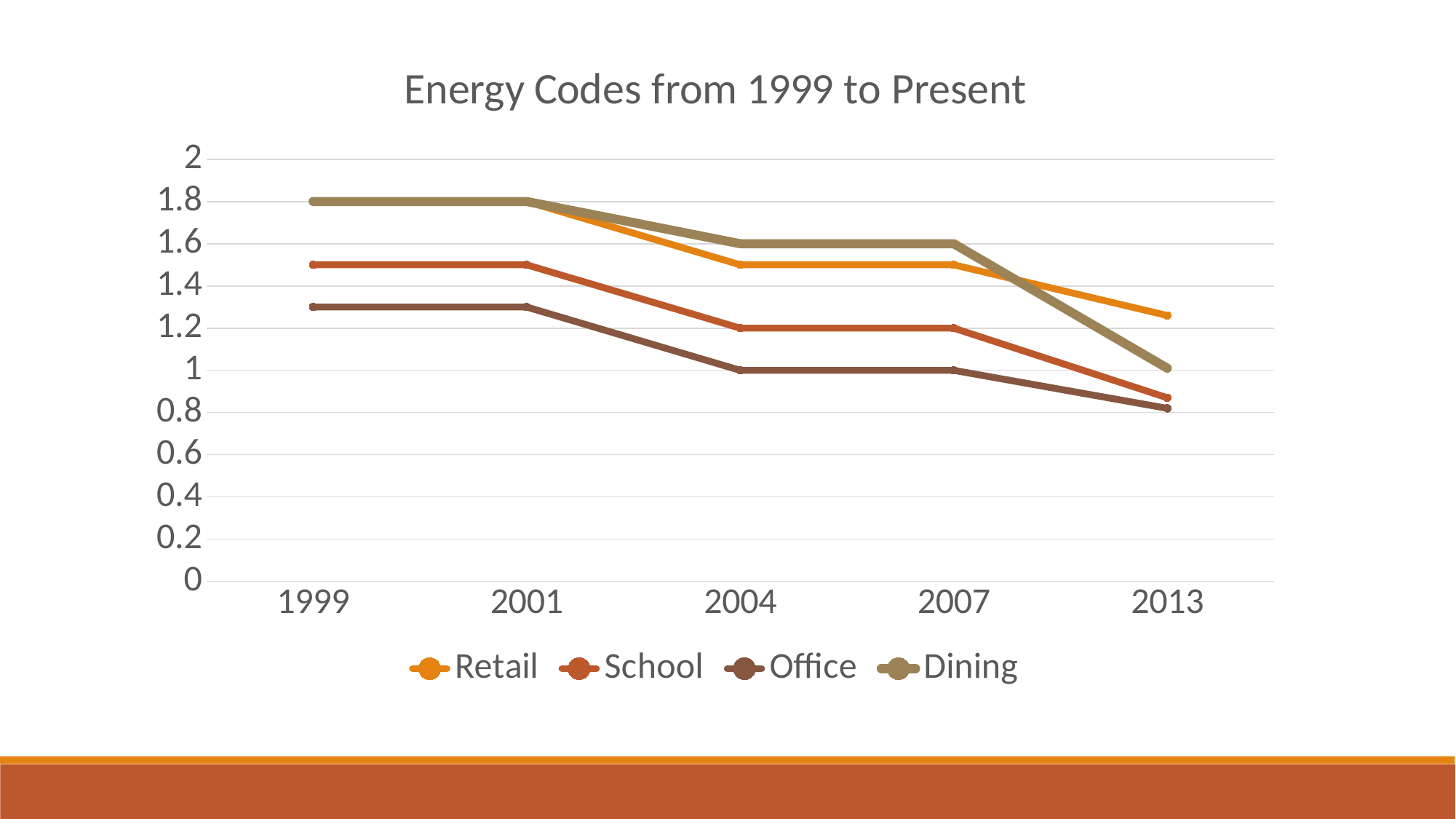
Does the Office series rise or fall from 1999 to 2013? fall What is the value for Office in 2004? 1 How many series does the legend list? 4 How many years are shown on the x axis? 5 What is the value for Retail in 1999? 1.8 What is the title of the chart? Energy Codes from 1999 to Present Which series has the highest value in 2013? Retail Is the value for Retail in 2013 greater or less than 1.4? less What is the value for School in 2004? 1.2 What is the difference between the Dining and School values in 2004? 0.4 What type of chart is shown on the slide? line chart What is the value for Dining in 2004? 1.6